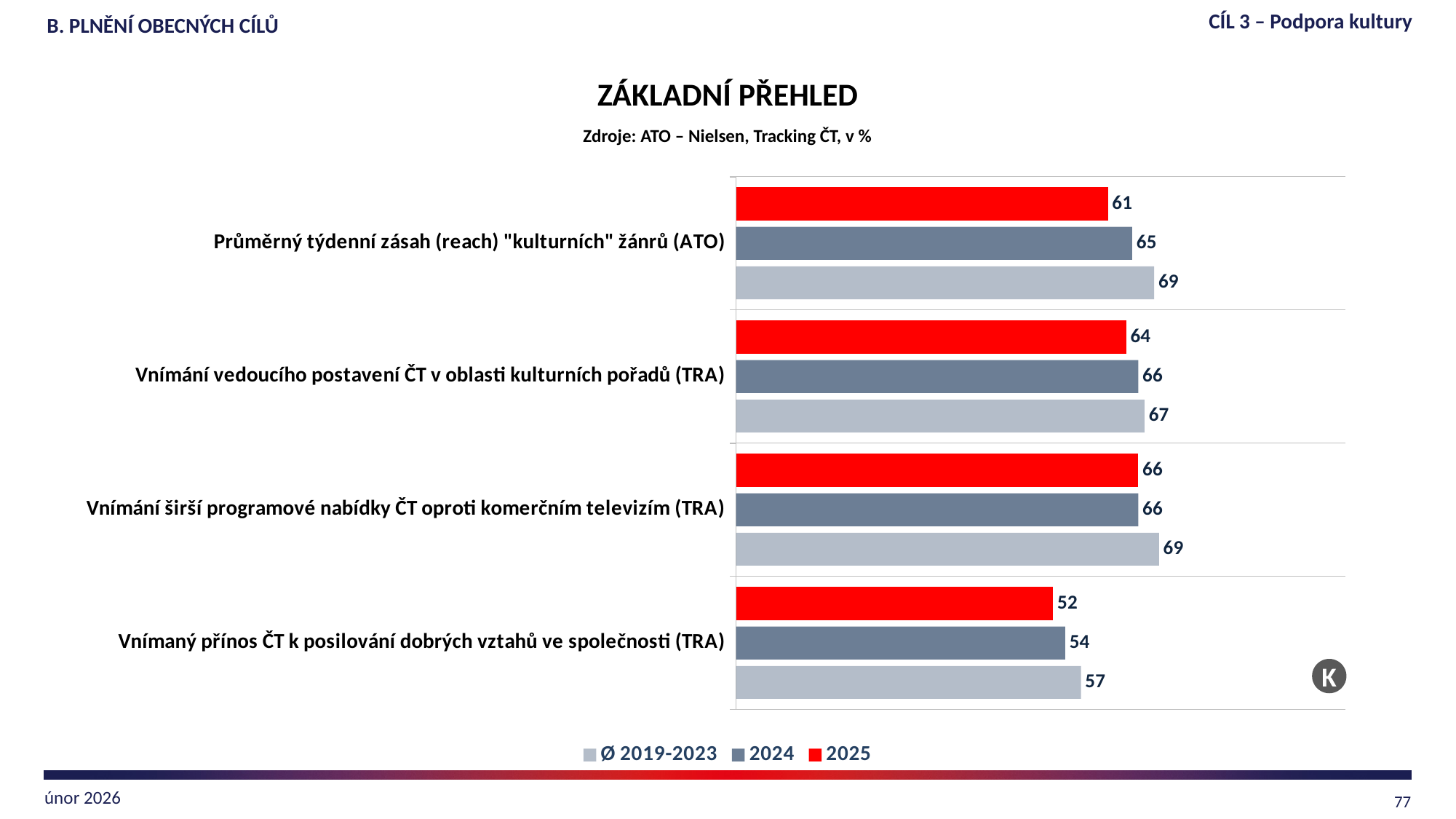
What is the 2024 value for "Vnímání vedoucího postavení ČT v oblasti kulturních pořadů (TRA)"? 66 How many categories are shown in the chart? 4 Which category has the highest 2025 value? Vnímání širší programové nabídky ČT oproti komerčním televizím (TRA) Which category has the lowest 2025 value? Vnímaný přínos ČT k posilování dobrých vztahů ve společnosti (TRA) What kind of chart is shown on the slide? Bar chart What is the 2025 value for "Průměrný týdenní zásah (reach) "kulturních" žánrů (ATO)"? 61 Which series is shown in red in the legend? 2025 For "Vnímání širší programové nabídky ČT oproti komerčním televizím (TRA)", is the 2025 value or the Ø 2019-2023 value larger? Ø 2019-2023 How many series does the legend list? 3 What is the difference between the Ø 2019-2023 value and the 2025 value for "Průměrný týdenní zásah (reach) "kulturních" žánrů (ATO)"? 8 What is the Ø 2019-2023 value for "Vnímaný přínos ČT k posilování dobrých vztahů ve společnosti (TRA)"? 57 What is the title of the chart? ZÁKLADNÍ PŘEHLED